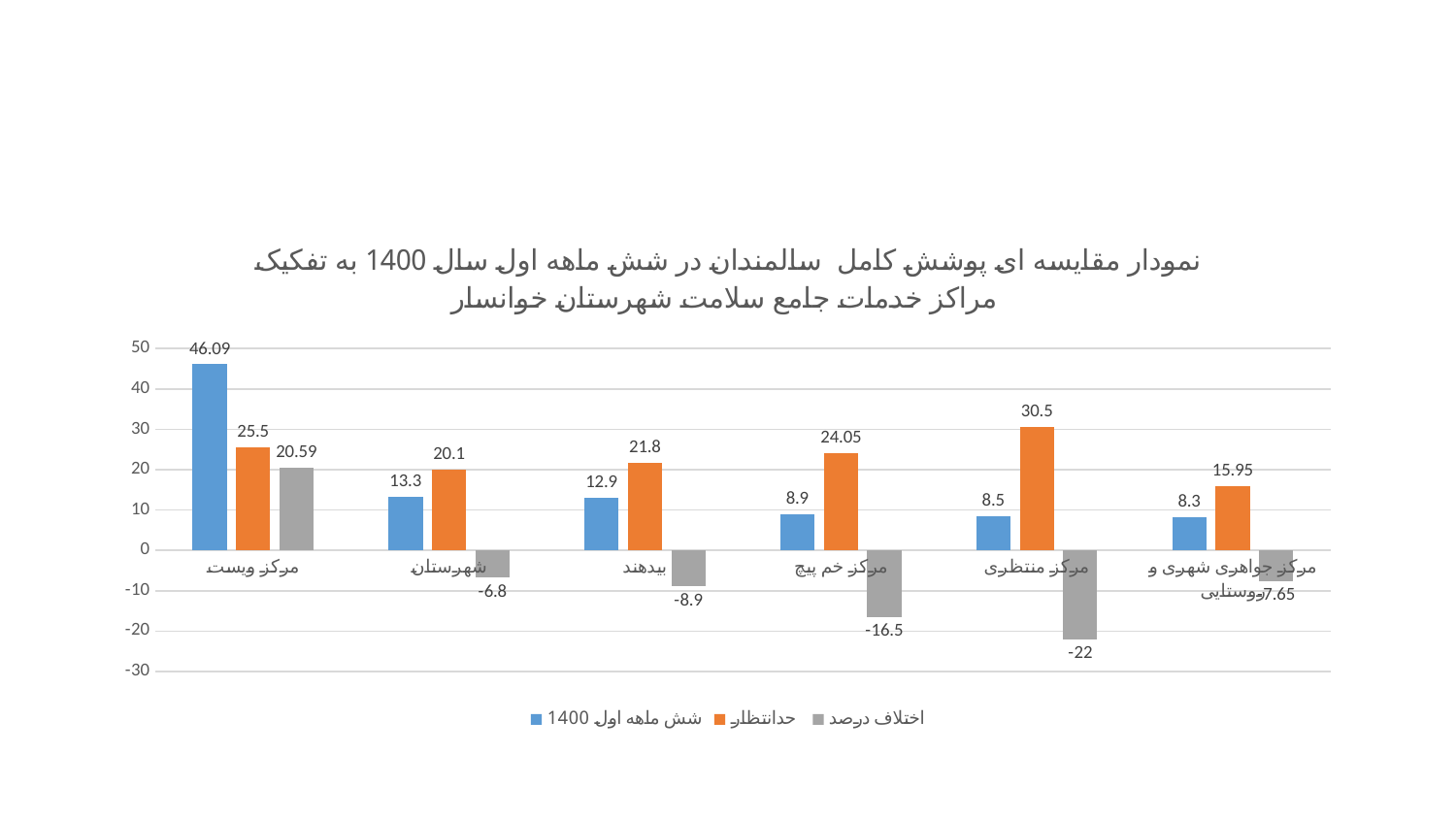
Is the اختلاف درصد value for مرکز جواهری شهری و روستایی greater or less than 0? less Which category has the lowest اختلاف درصد value? مرکز منتظری What type of chart is shown on the slide? bar chart What is the value of the شش ماهه اول 1400 series for مرکز ویست? 46.09 What is the اختلاف درصد value for مرکز خم پیچ? -16.5 How many categories are shown on the x axis? 6 What is the difference between the حدانتظار value and the شش ماهه اول 1400 value for شهرستان? 6.8 What is the حدانتظار value for مرکز منتظری? 30.5 For مرکز خم پیچ, which is larger: the شش ماهه اول 1400 value or the حدانتظار value? حدانتظار Which category has the highest value in the شش ماهه اول 1400 series? مرکز ویست How many series does the legend list? 3 What is the حدانتظار value for بیدهند? 21.8